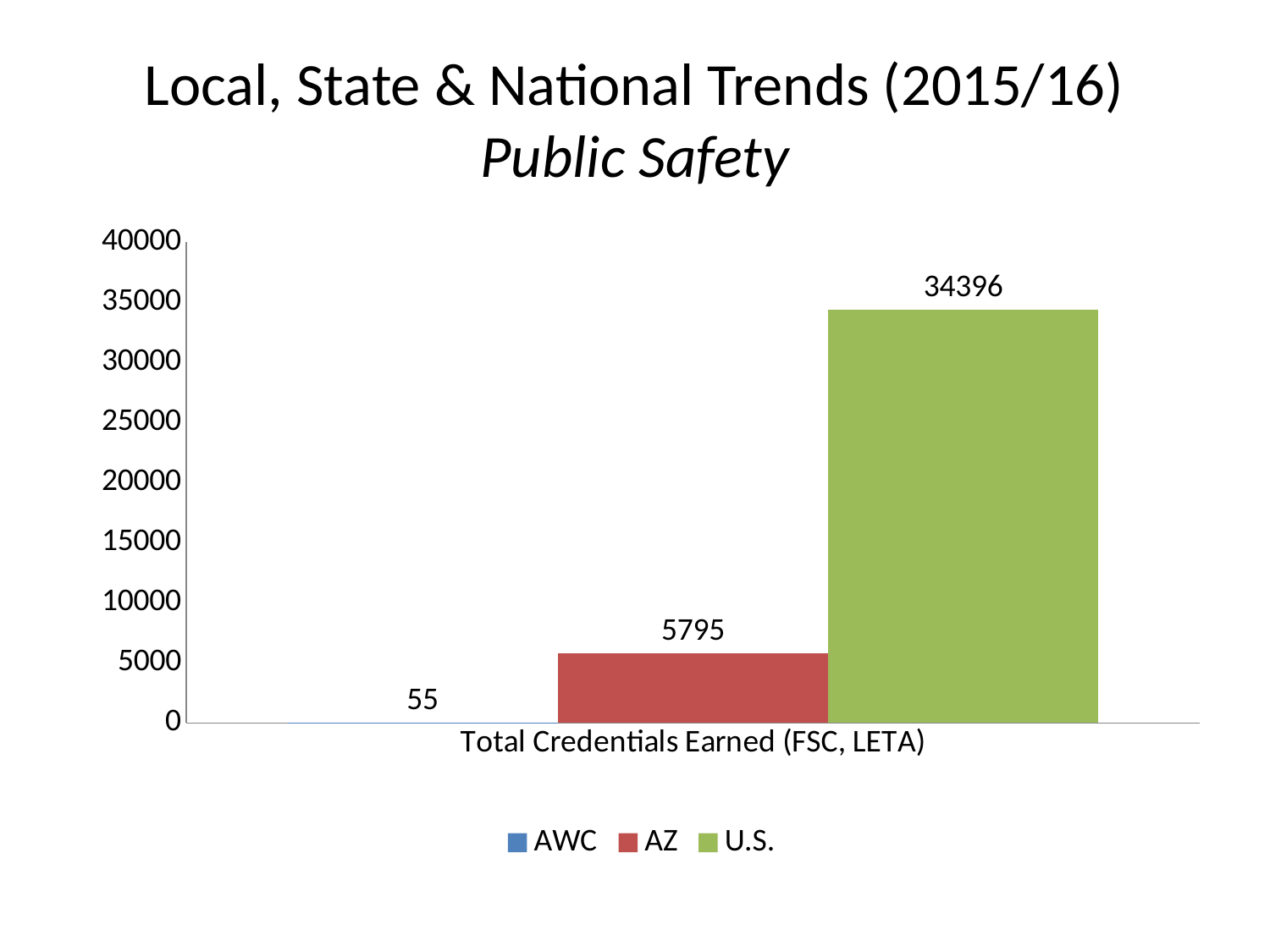
What is the value for AWC in Total Credentials Earned (FSC, LETA)? 55 Which series has the highest value for Total Credentials Earned (FSC, LETA)? U.S. What is the value for AZ in Total Credentials Earned (FSC, LETA)? 5795 Which series has the lowest value for Total Credentials Earned (FSC, LETA)? AWC What kind of chart is shown on the slide? bar chart What is the difference between the U.S. and AZ values for Total Credentials Earned (FSC, LETA)? 28601 What is the category label on the x axis of the chart? Total Credentials Earned (FSC, LETA) How many series does the legend list? 3 Which is larger, the value for AZ or the value for AWC? AZ Is the value for U.S. greater or less than 30000? greater What is the difference between the AZ and AWC values for Total Credentials Earned (FSC, LETA)? 5740 What is the value for U.S. in Total Credentials Earned (FSC, LETA)? 34396